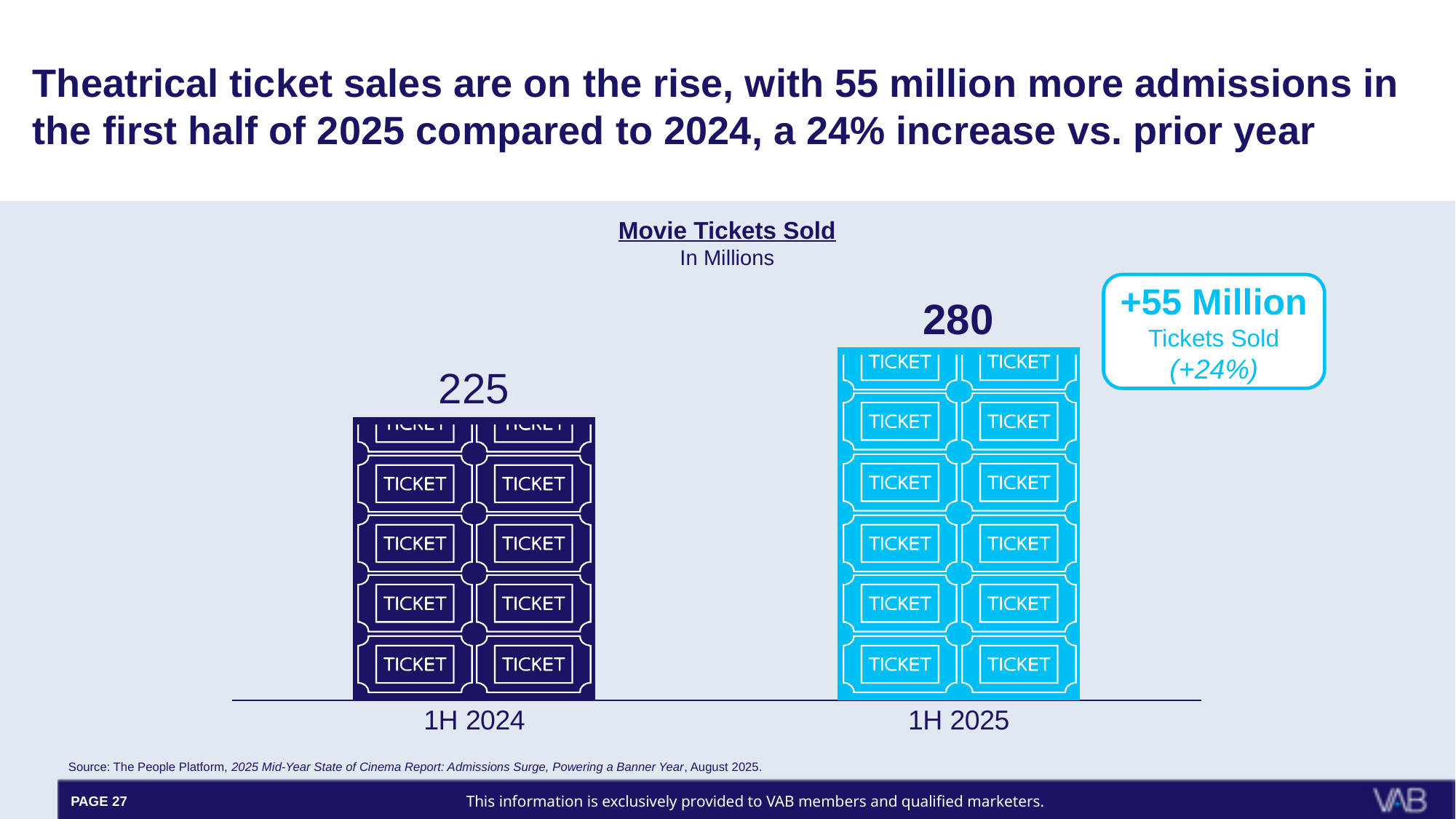
What is the value for 1H 2025 in the Movie Tickets Sold chart? 280 Which period has the highest number of movie tickets sold? 1H 2025 In what units are the chart values expressed? In Millions How many periods are shown in the Movie Tickets Sold chart? 2 Do the values rise or fall from 1H 2024 to 1H 2025? Rise What percentage increase is shown in the callout box next to the chart? +24% Which is larger, the value for 1H 2024 or the value for 1H 2025? 1H 2025 What kind of chart is used to show Movie Tickets Sold? Bar chart What is the title of the chart? Movie Tickets Sold Which period has the lowest number of movie tickets sold? 1H 2024 What is the value for 1H 2024 in the Movie Tickets Sold chart? 225 What is the difference in movie tickets sold between 1H 2025 and 1H 2024? 55